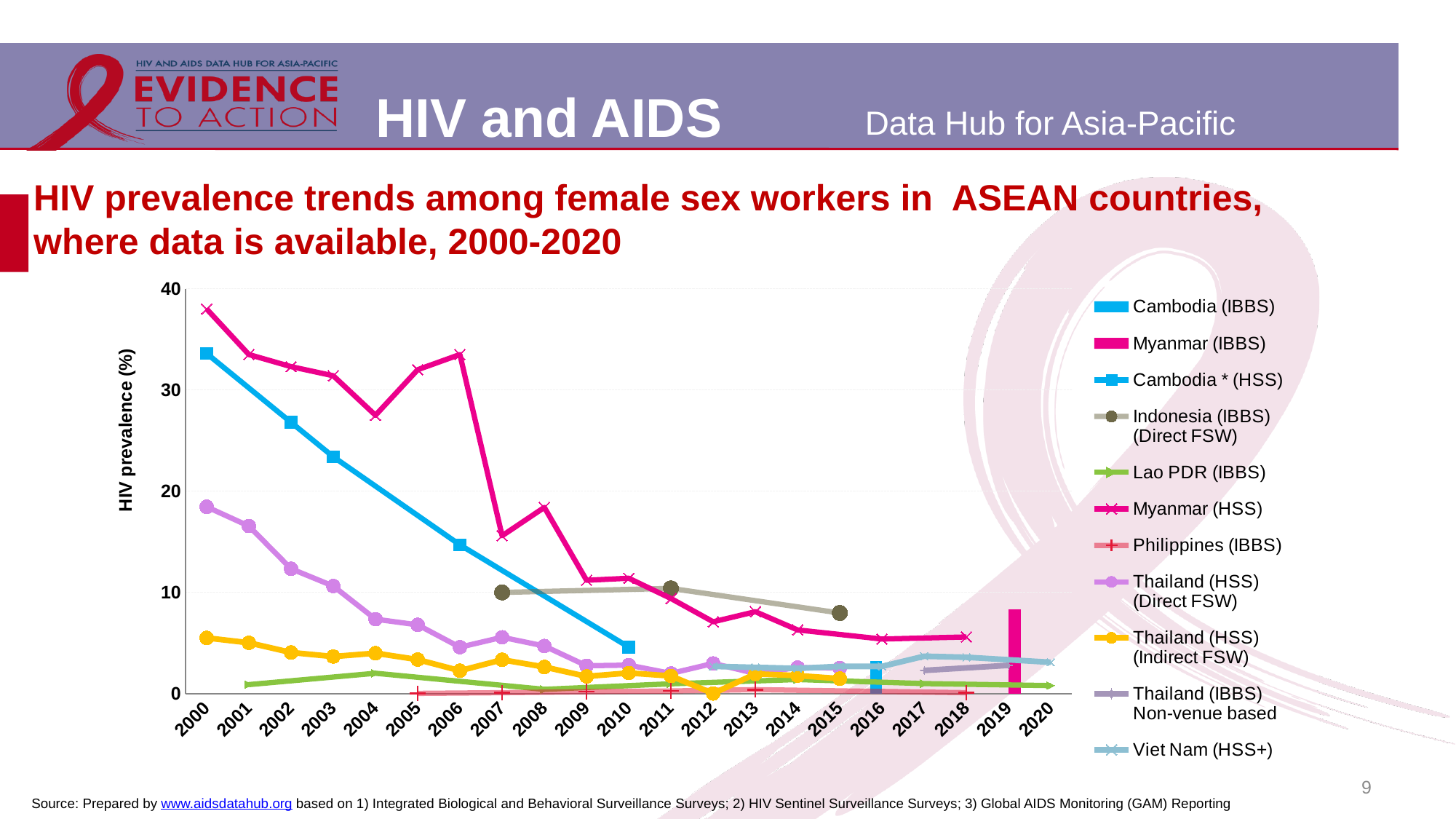
Is the value for Myanmar (HSS) in 2000 greater or less than 30? greater Does the Cambodia * (HSS) series rise or fall from 2000 to 2010? fall How many series does the chart legend list? 11 Is the value for Myanmar (IBBS) in 2019 greater or less than 10? less How many years are labelled along the x axis of the chart? 21 What kind of chart is used to plot the Myanmar (HSS) series? line chart Is the value for Indonesia (IBBS) (Direct FSW) in 2015 greater or less than 10? less In 2000, which is larger: the value for Myanmar (HSS) or the value for Cambodia * (HSS)? Myanmar (HSS) Which series has the highest value in 2000? Myanmar (HSS) What is the label on the y axis of the chart? HIV prevalence (%) In which year does the Myanmar (HSS) series reach its highest value? 2000